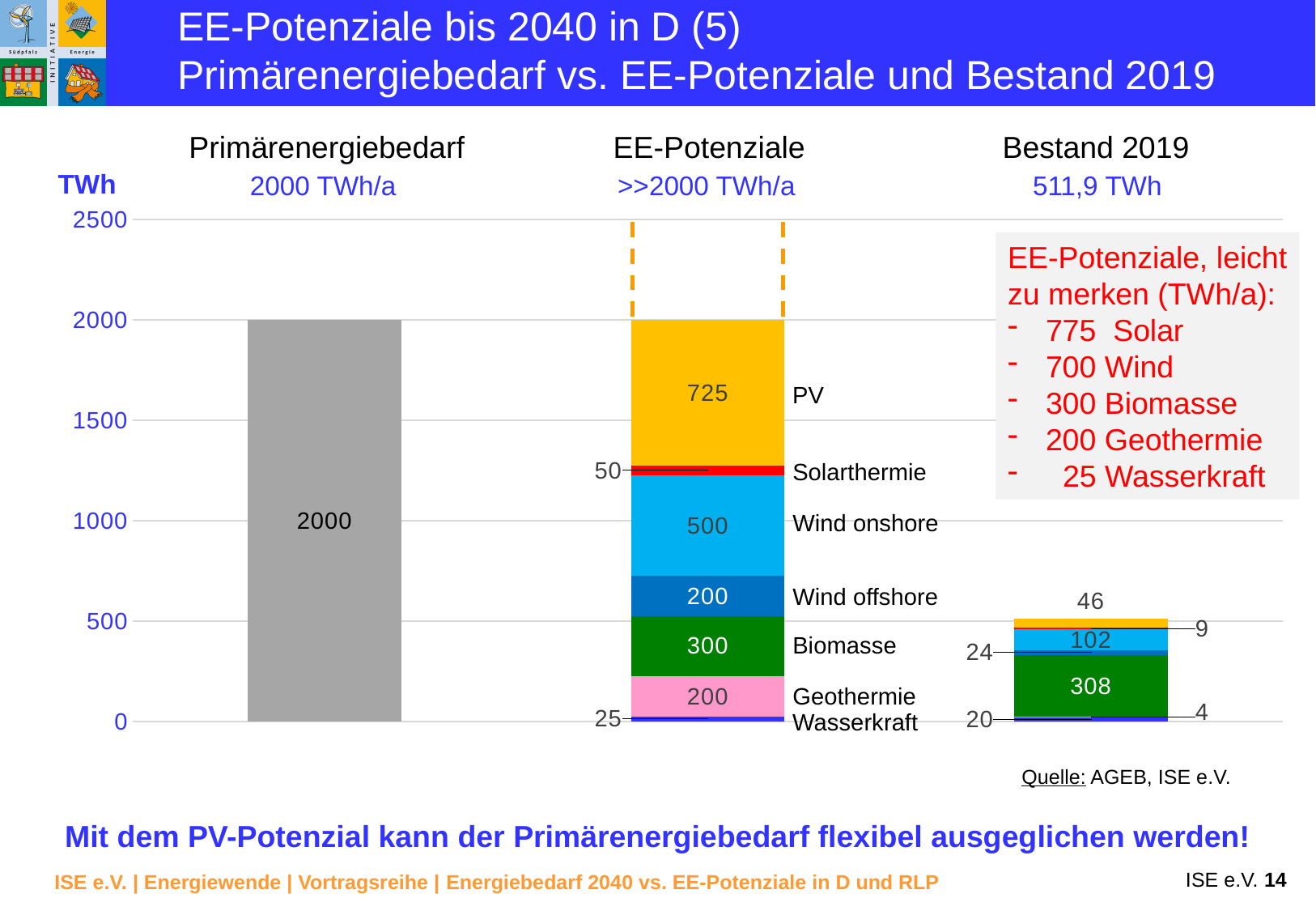
In the EE-Potenziale bar, which is larger: Biomasse or Geothermie? Biomasse What kind of chart is shown on the slide? Stacked bar chart In the EE-Potenziale bar, what is the value for Wind onshore? 500 Which segment is the largest in the EE-Potenziale bar? PV In the Bestand 2019 bar, what is the value of the green Biomasse segment? 308 Which segment is the smallest in the EE-Potenziale bar? Wasserkraft How many segments make up the EE-Potenziale stacked bar? 7 In the EE-Potenziale bar, what is the difference between Wind onshore and Wind offshore? 300 What is the total of the EE-Potenziale stacked bar? 2000 Is the total height of the Bestand 2019 bar greater or less than 1000? less What is the value of the Primärenergiebedarf bar? 2000 In the EE-Potenziale bar, what is the value for PV? 725